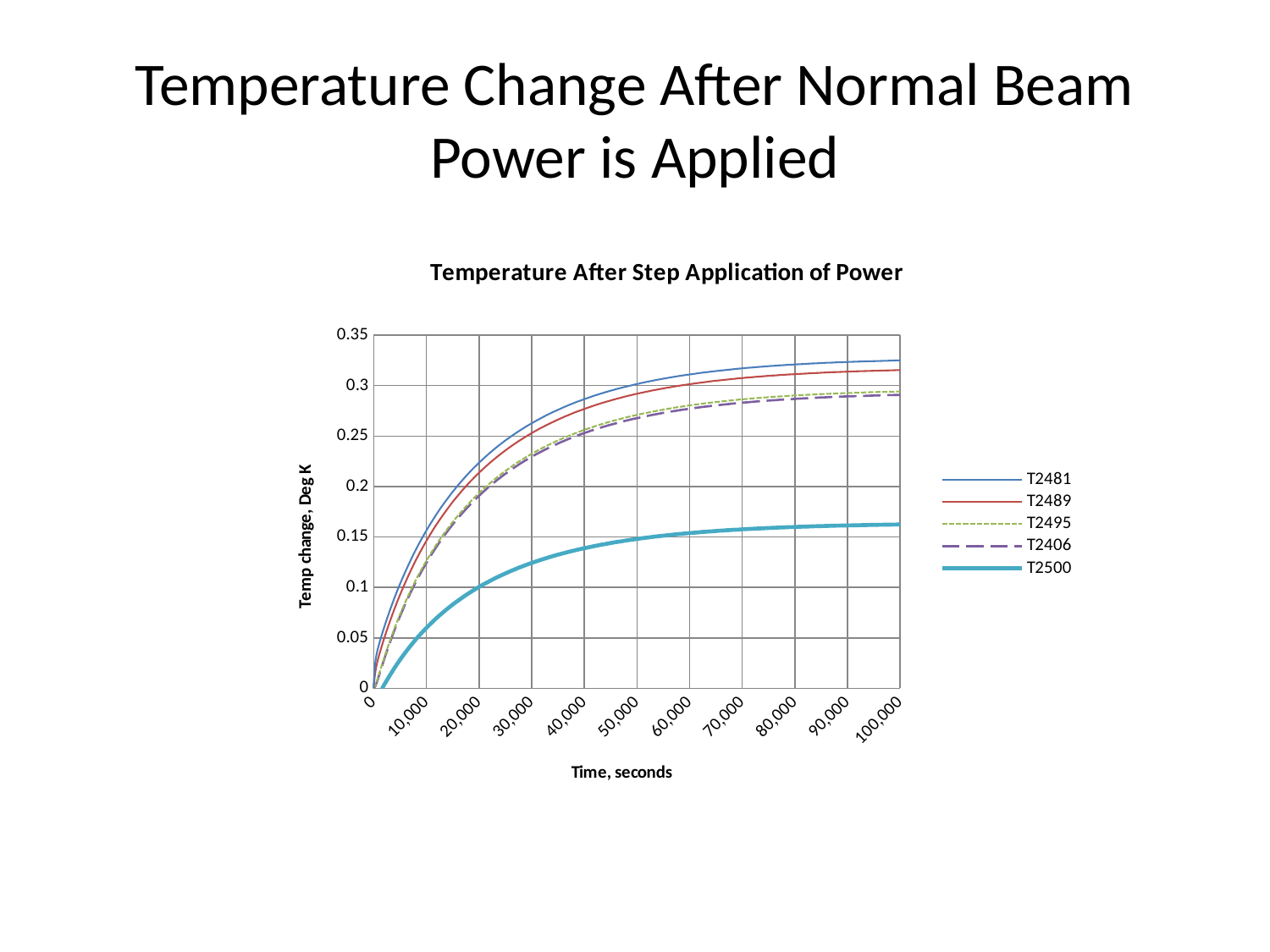
At 100,000 seconds, which is larger: T2489 or T2406? T2489 What is the label of the vertical axis? Temp change, Deg K What is the title of the chart? Temperature After Step Application of Power Is the value for T2500 at 100,000 seconds greater or less than 0.2? less What kind of chart is shown on the slide? line chart At 100,000 seconds, which is larger: T2500 or T2481? T2481 Is the value for T2500 at 30,000 seconds greater or less than 0.1? greater Do the values for T2500 rise or fall as time increases along the x axis? rise Is the value for T2481 at 100,000 seconds greater or less than 0.3? greater How many series does the legend list? 5 Which series has the highest temperature change at 100,000 seconds? T2481 Which series has the lowest temperature change at 100,000 seconds? T2500